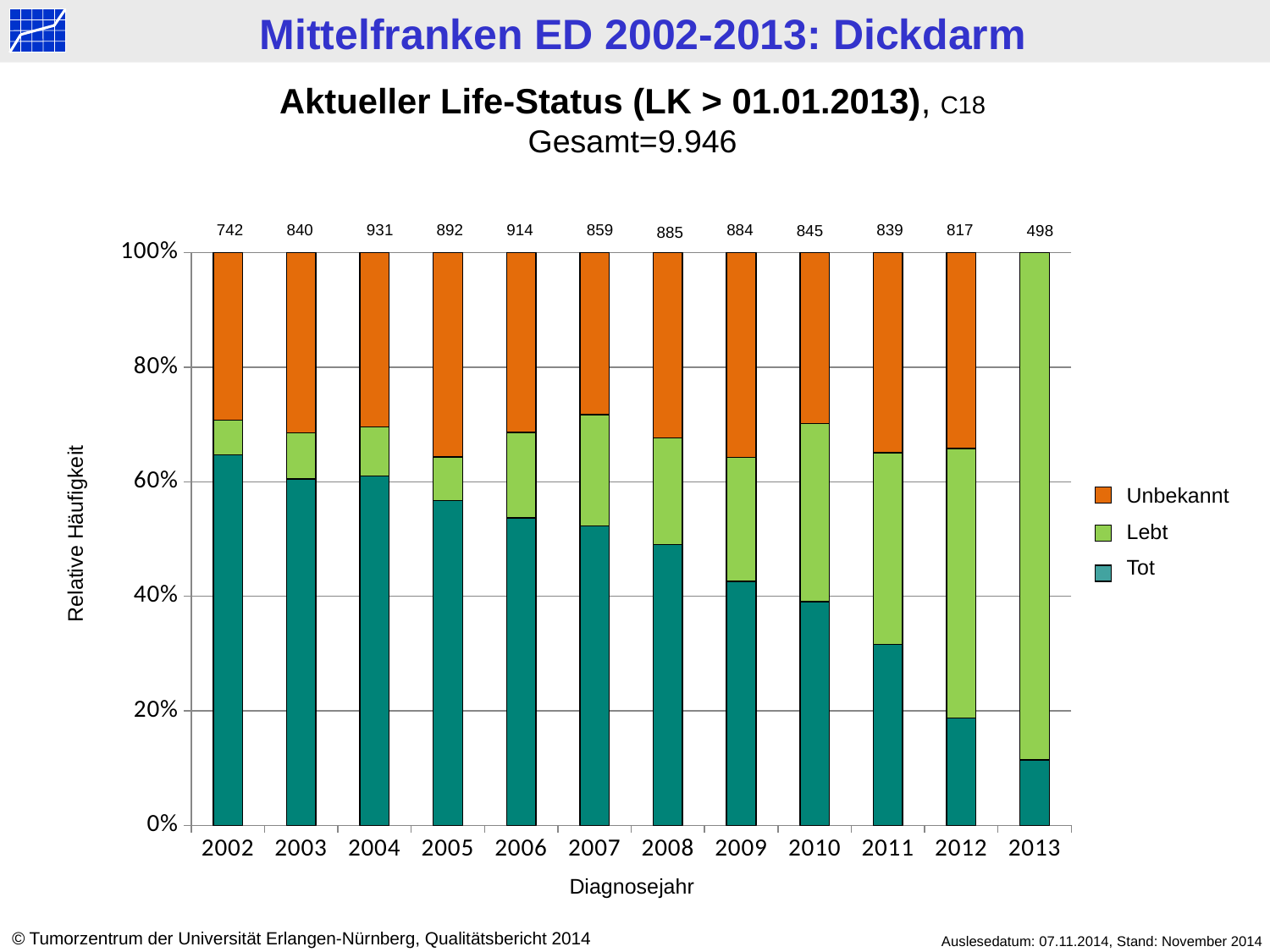
Which diagnosis year has the highest number printed above its bar? 2004 What is the difference between the numbers printed above the bars for 2004 and 2013? 433 What is the number printed above the bar for 2004? 931 Which diagnosis year has the lowest number printed above its bar? 2013 What kind of chart is shown on the slide? stacked bar chart Is the share of 'Tot' in 2002 greater or less than 60%? greater Is the share of 'Tot' in 2013 greater or less than 20%? less Does the share of 'Tot' rise or fall from 2002 to 2013? fall What is the number printed above the bar for 2008? 885 What is the number printed above the bar for 2013? 498 How many diagnosis years (categories) are shown on the x axis? 12 How many series does the legend list? 3